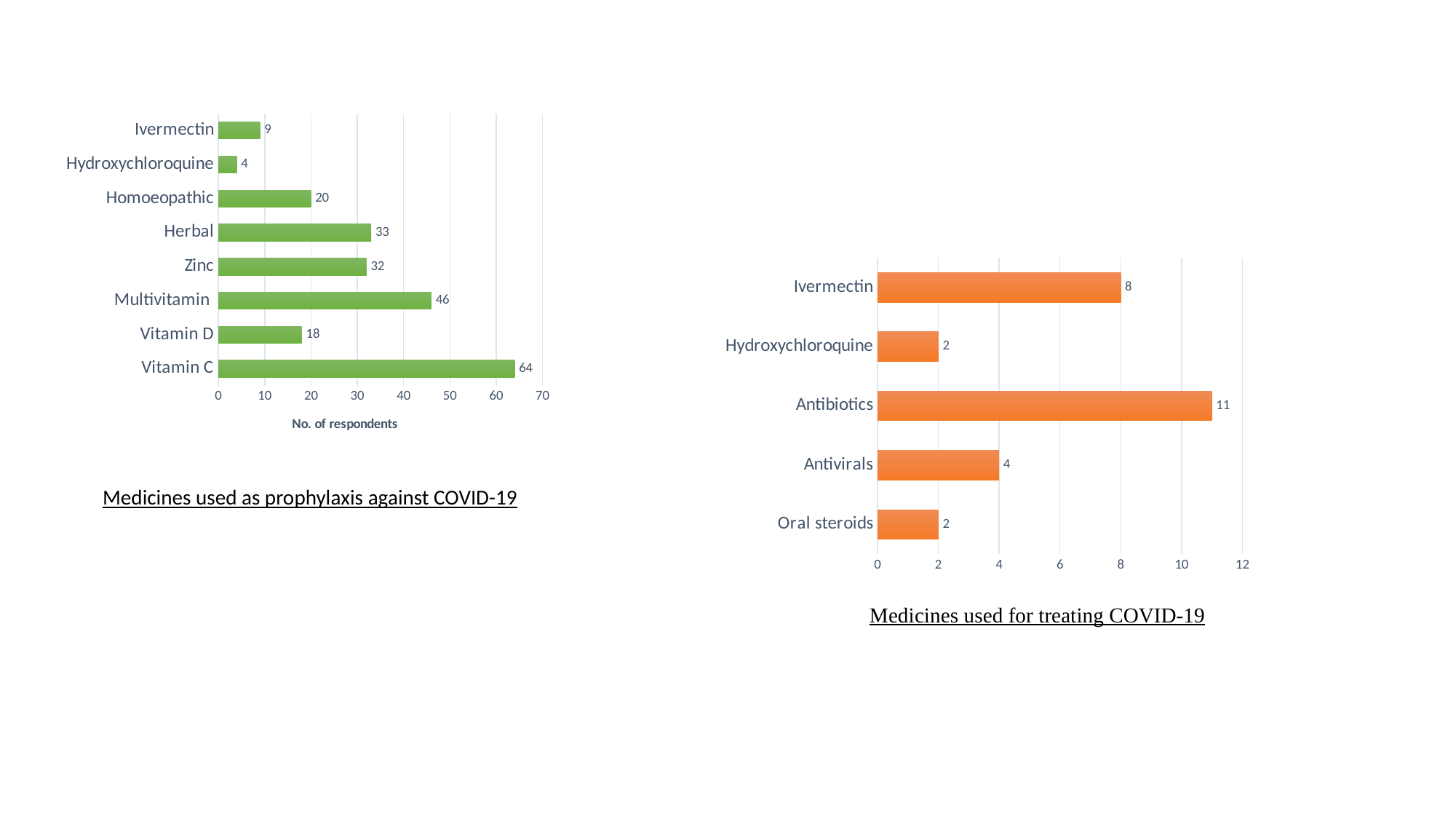
In the 'Medicines used as prophylaxis against COVID-19' chart, how many respondents used Vitamin C? 64 In the 'Medicines used for treating COVID-19' chart, which medicine has the highest value? Antibiotics In the 'Medicines used as prophylaxis against COVID-19' chart, which medicine has the highest number of respondents? Vitamin C In the 'Medicines used as prophylaxis against COVID-19' chart, which medicine has the lowest number of respondents? Hydroxychloroquine In the 'Medicines used for treating COVID-19' chart, which is larger, the value for Ivermectin or the value for Antivirals? Ivermectin In the 'Medicines used for treating COVID-19' chart, how many medicine categories are shown? 5 In the 'Medicines used as prophylaxis against COVID-19' chart, what is the difference between the values for Vitamin C and Multivitamin? 18 In the 'Medicines used for treating COVID-19' chart, what is the value for Antibiotics? 11 In the 'Medicines used as prophylaxis against COVID-19' chart, how many medicine categories are shown? 8 In the 'Medicines used as prophylaxis against COVID-19' chart, what is the label of the horizontal axis? No. of respondents In the 'Medicines used as prophylaxis against COVID-19' chart, what is the value for Multivitamin? 46 What type of chart is the 'Medicines used for treating COVID-19' chart? Bar chart